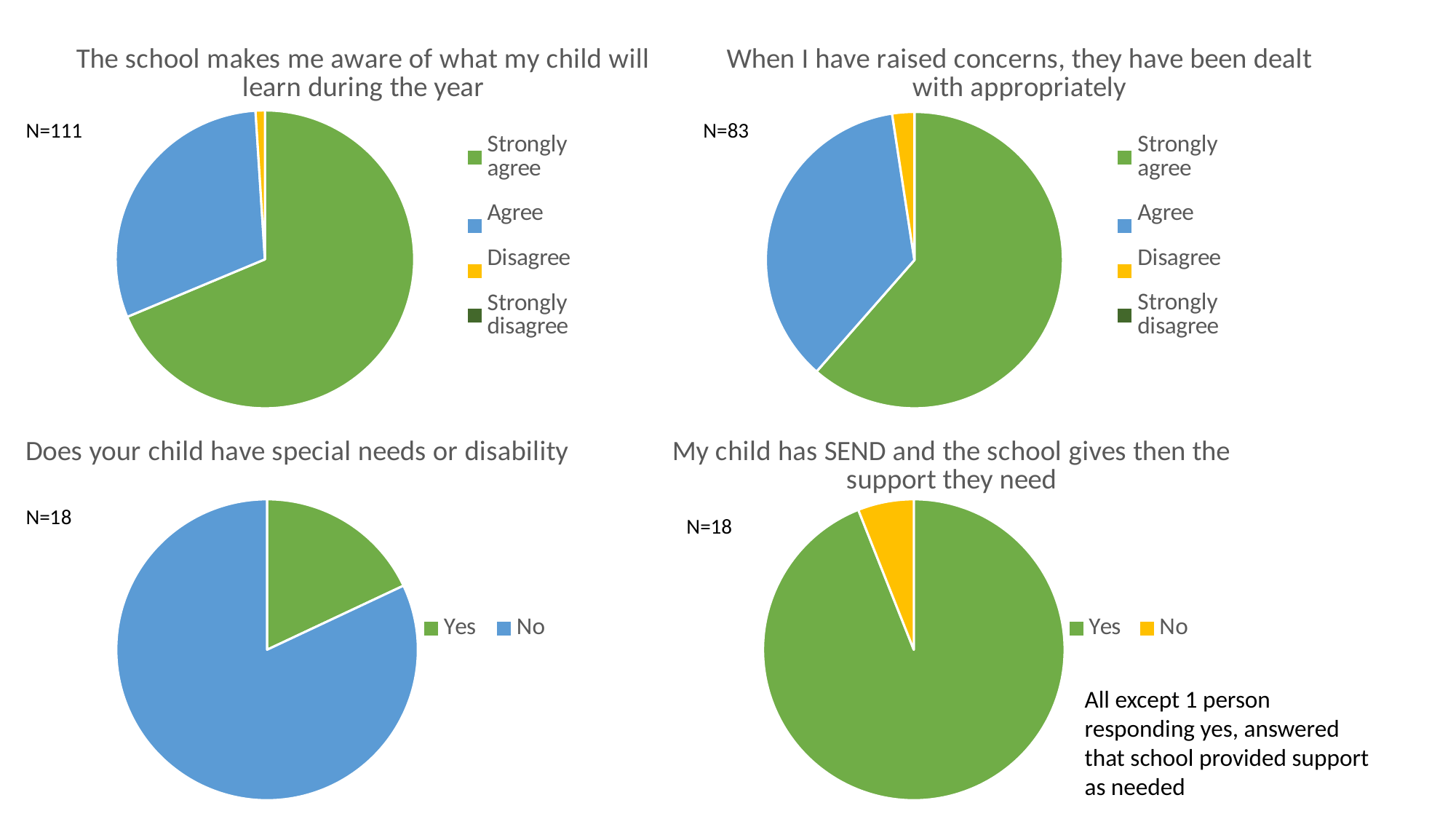
In the chart 'The school makes me aware of what my child will learn during the year', which response has the largest slice? Strongly agree How many entries does the legend list for the chart 'The school makes me aware of what my child will learn during the year'? 4 How many pie charts are shown on the slide? 4 In the chart 'When I have raised concerns, they have been dealt with appropriately', which response has the largest slice? Strongly agree In the chart 'My child has SEND and the school gives then the support they need', which response has the smallest slice? No In the chart 'Does your child have special needs or disability', which response has the largest slice? No In the chart 'When I have raised concerns, they have been dealt with appropriately', which slice is larger, Strongly agree or Agree? Strongly agree What is the N value shown for the chart 'When I have raised concerns, they have been dealt with appropriately'? N=83 In the chart 'The school makes me aware of what my child will learn during the year', which slice is larger, Agree or Disagree? Agree How many entries does the legend list for the chart 'Does your child have special needs or disability'? 2 What is the N value shown for the chart 'The school makes me aware of what my child will learn during the year'? N=111 What kind of chart is 'The school makes me aware of what my child will learn during the year'? Pie chart